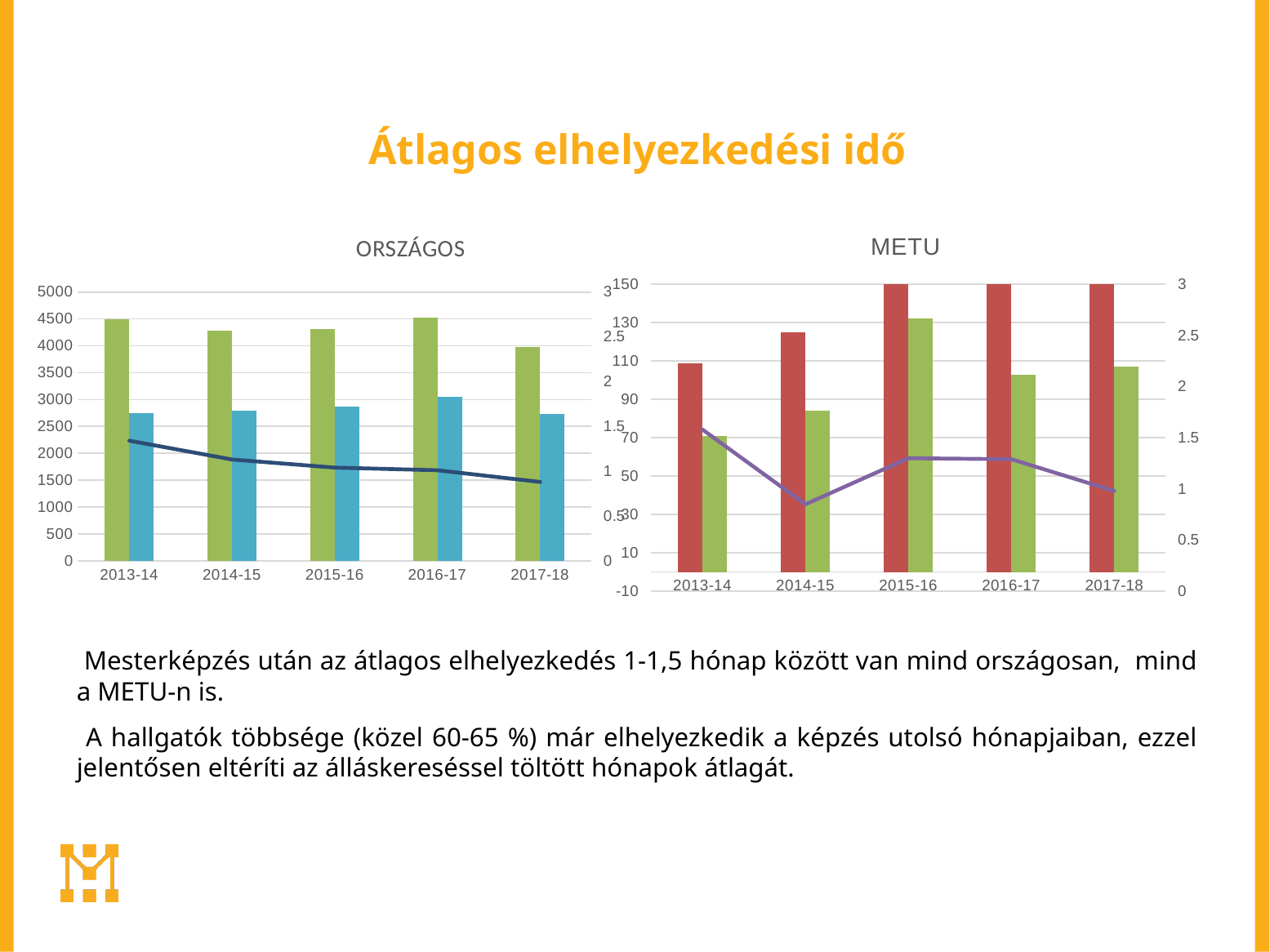
In the ORSZÁGOS chart, is the green bar for 2013-14 greater or less than 4000? greater In the METU chart, which year has the lowest red bar? 2013-14 In the METU chart, is the green bar for 2015-16 greater or less than 110? greater In the ORSZÁGOS chart, is the blue bar for 2013-14 greater or less than 3000? less In the METU chart, which year has the highest green bar? 2015-16 In the ORSZÁGOS chart, which year has the highest blue bar? 2016-17 What is the title of the chart on the right? METU How many academic-year categories are shown on the x axis of the METU chart? 5 What kind of chart is the ORSZÁGOS chart on the left? bar chart with a line In the ORSZÁGOS chart for 2013-14, which bar is taller, the green one or the blue one? green In the ORSZÁGOS chart, which year has the lowest green bar? 2017-18 In the ORSZÁGOS chart, does the line rise or fall from 2013-14 to 2017-18? fall